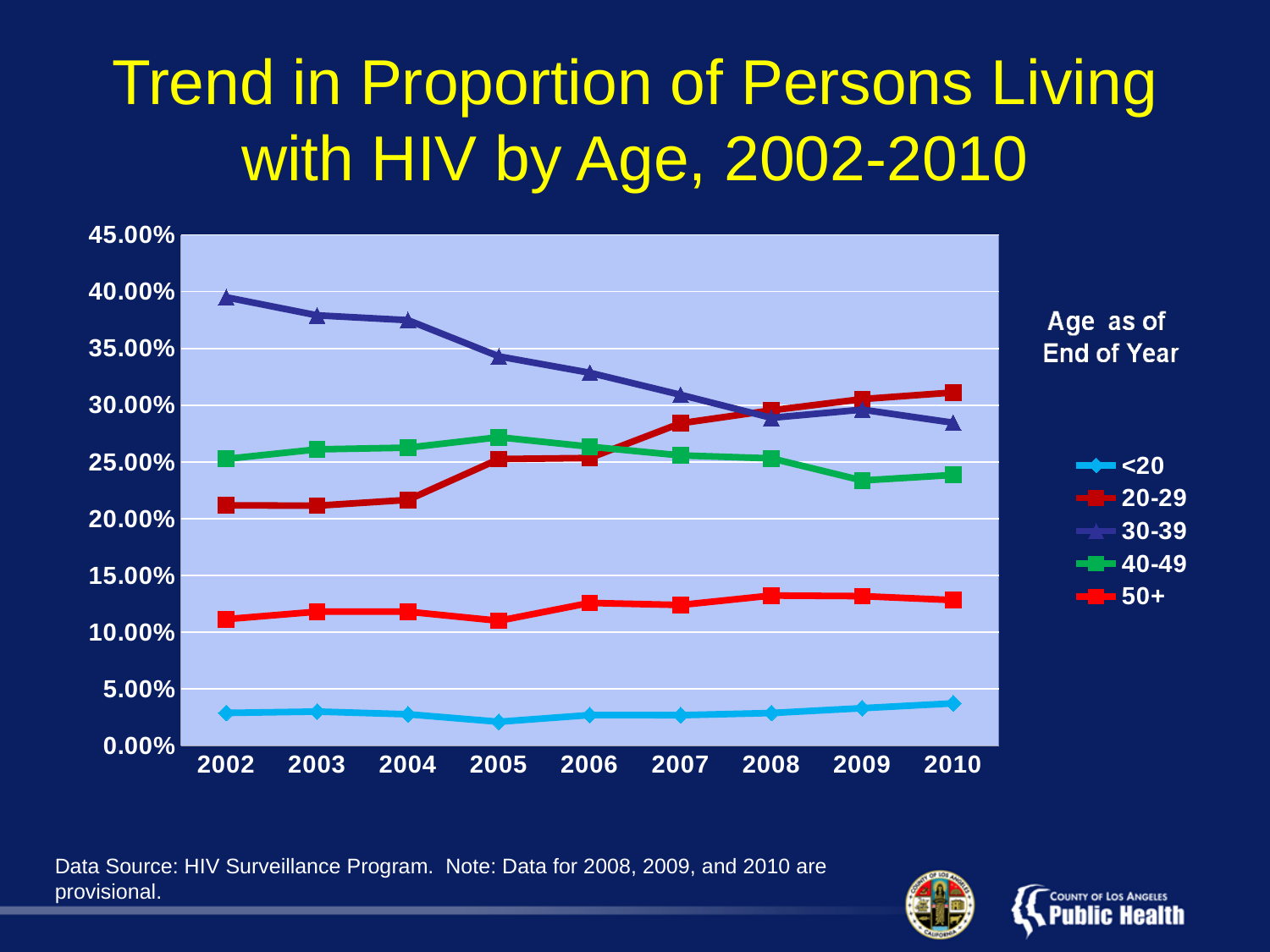
Is the value for the 50+ age group in 2008 greater or less than 10.00%? greater Does the proportion for the 20-29 age group rise or fall from 2002 to 2010? rise Which age group has the lowest proportion across all years shown? <20 How many years are plotted along the x axis? 9 Is the value for the 30-39 age group in 2002 greater or less than 35.00%? greater Is the value for the 20-29 age group in 2010 greater or less than 25.00%? greater Which age group has the highest proportion in 2010? 20-29 How many series does the legend list? 5 What kind of chart is shown on the slide? line chart In 2002, which age group has the larger proportion, 30-39 or 20-29? 30-39 Does the proportion for the 30-39 age group rise or fall from 2002 to 2010? fall